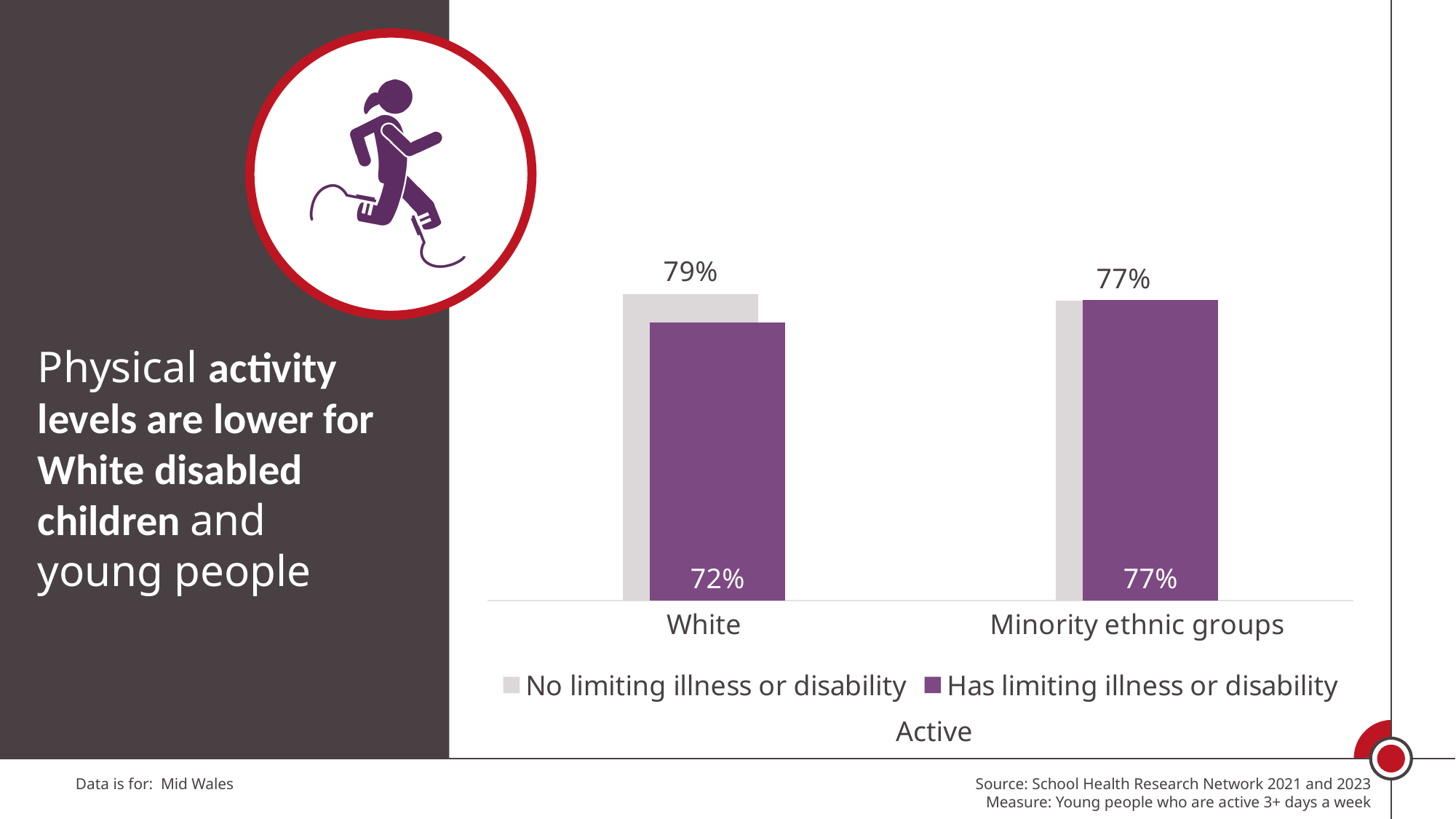
Which category has the highest value in the 'No limiting illness or disability' series? White How many series does the chart legend list? 2 What type of chart is shown on the slide? Bar chart What percentage of White young people who have a limiting illness or disability are active? 72% What is the difference between the 'No limiting illness or disability' and 'Has limiting illness or disability' values for White? 7 percentage points Which category has the lowest value in the 'Has limiting illness or disability' series? White How many categories are shown on the x axis of the chart? 2 What is the value for Minority ethnic groups in the 'Has limiting illness or disability' series? 77% Which colour represents the 'Has limiting illness or disability' series in the chart? Purple What is the value for Minority ethnic groups in the 'No limiting illness or disability' series? 77% What percentage of White young people with no limiting illness or disability are active? 79% For White young people, which is larger: the value for those with no limiting illness or disability, or those who have a limiting illness or disability? No limiting illness or disability